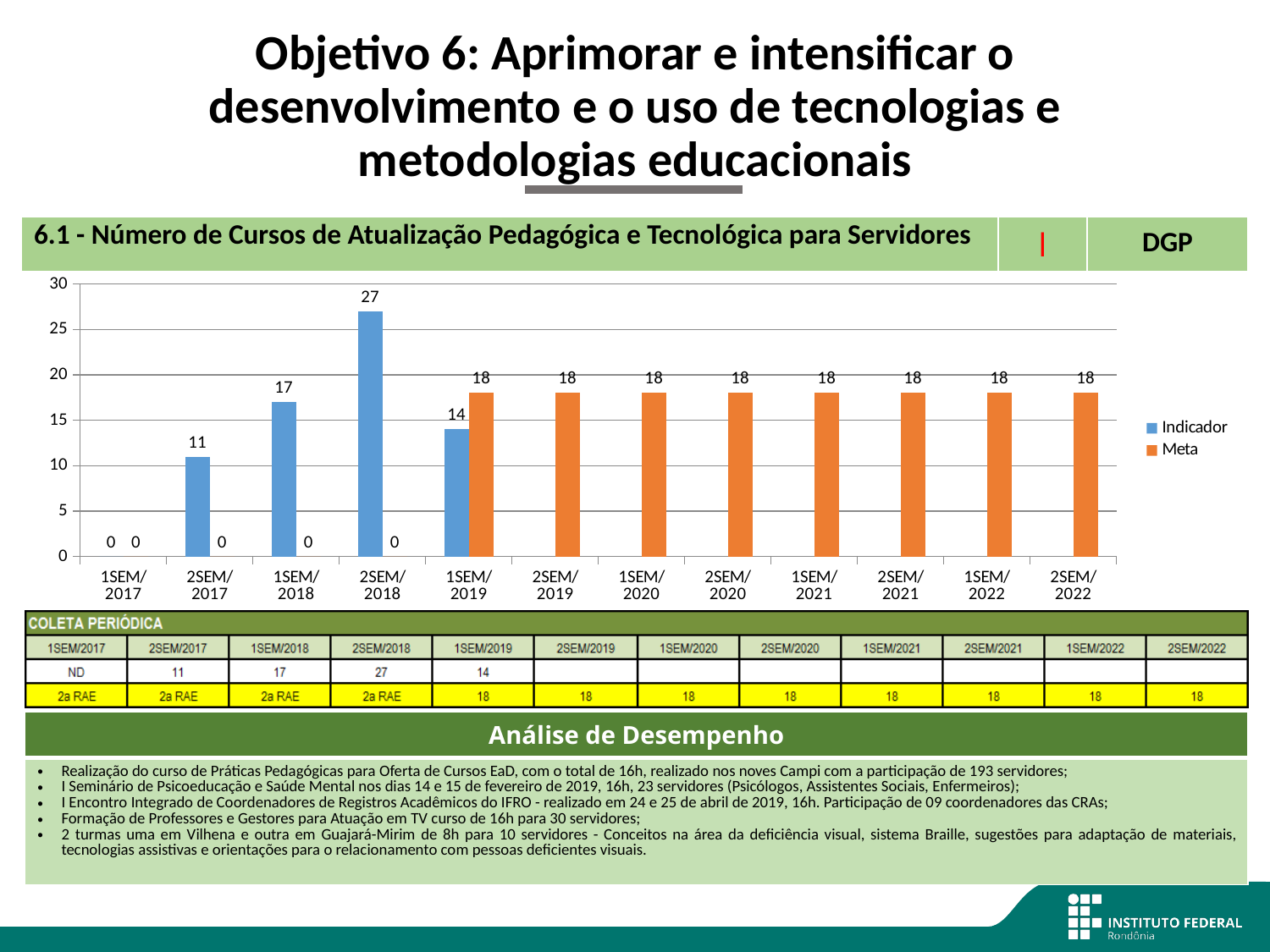
Is the Indicador value for 2SEM/2018 greater or less than 25? greater What is the Meta value for 2SEM/2020? 18 What is the Indicador value for 2SEM/2017? 11 What is the difference between the Indicador values for 2SEM/2018 and 1SEM/2018? 10 What is the difference between the Meta and the Indicador for 1SEM/2019? 4 Which period has the highest Indicador value? 2SEM/2018 How many series does the chart legend list? 2 What is the Indicador value for 1SEM/2019? 14 Which is larger for 1SEM/2019, the Indicador or the Meta? Meta What kind of chart is shown on the slide? Bar chart How many periods are shown on the x axis of the chart? 12 What is the Indicador value for 2SEM/2018? 27